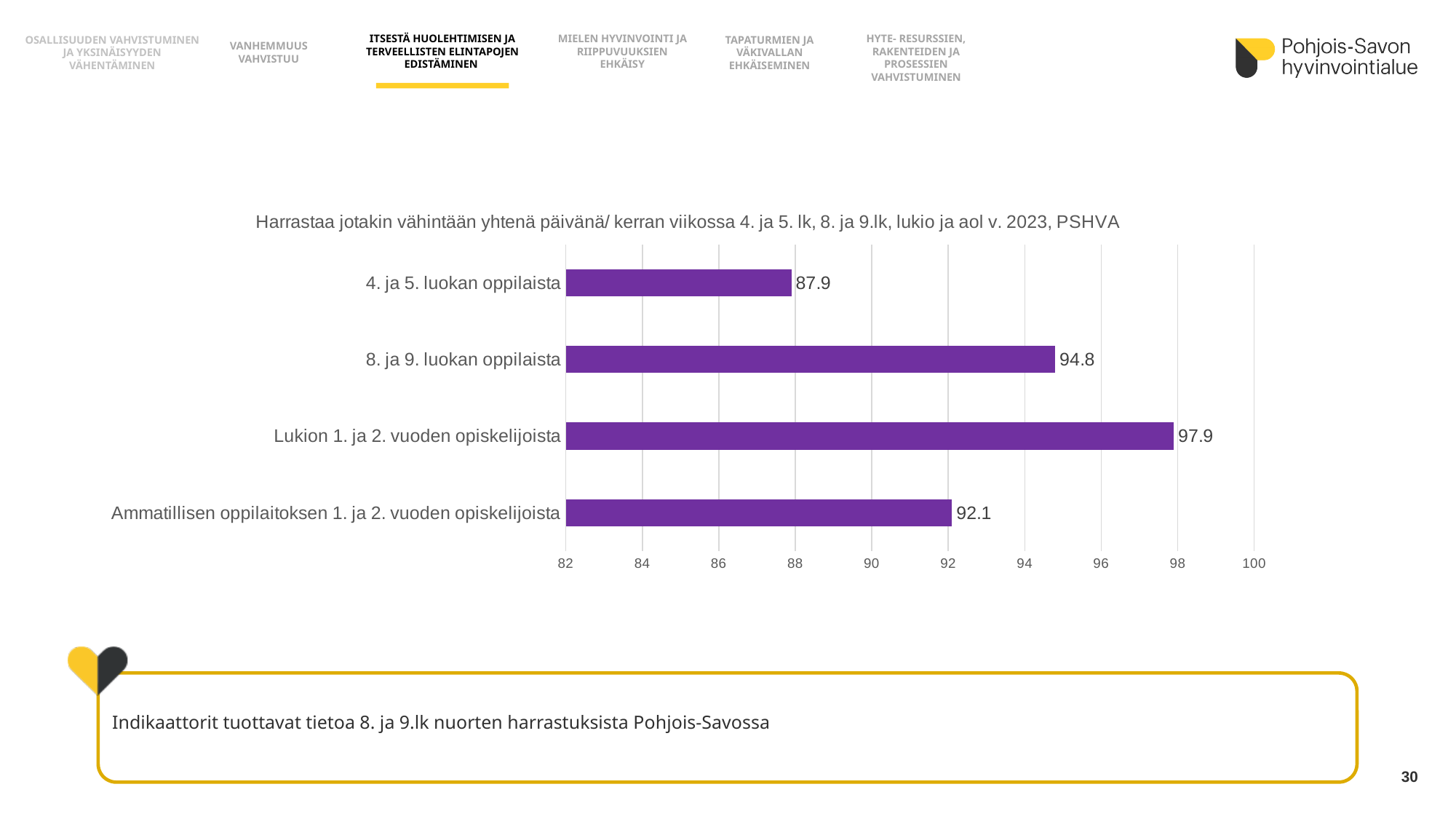
What is the difference between the values for 8. ja 9. luokan oppilaista and Ammatillisen oppilaitoksen 1. ja 2. vuoden opiskelijoista? 2.7 Which category has the highest value? Lukion 1. ja 2. vuoden opiskelijoista Which category has the lowest value? 4. ja 5. luokan oppilaista What is the value for 4. ja 5. luokan oppilaista? 87.9 Which is larger: the value for 8. ja 9. luokan oppilaista or the value for Ammatillisen oppilaitoksen 1. ja 2. vuoden opiskelijoista? 8. ja 9. luokan oppilaista How many categories are shown in the chart? 4 What is the difference between the values for Lukion 1. ja 2. vuoden opiskelijoista and 4. ja 5. luokan oppilaista? 10 What kind of chart is shown on the slide? bar chart What is the value for 8. ja 9. luokan oppilaista? 94.8 What is the value for Lukion 1. ja 2. vuoden opiskelijoista? 97.9 What is the value for Ammatillisen oppilaitoksen 1. ja 2. vuoden opiskelijoista? 92.1 Is the value for 4. ja 5. luokan oppilaista greater or less than 90? less